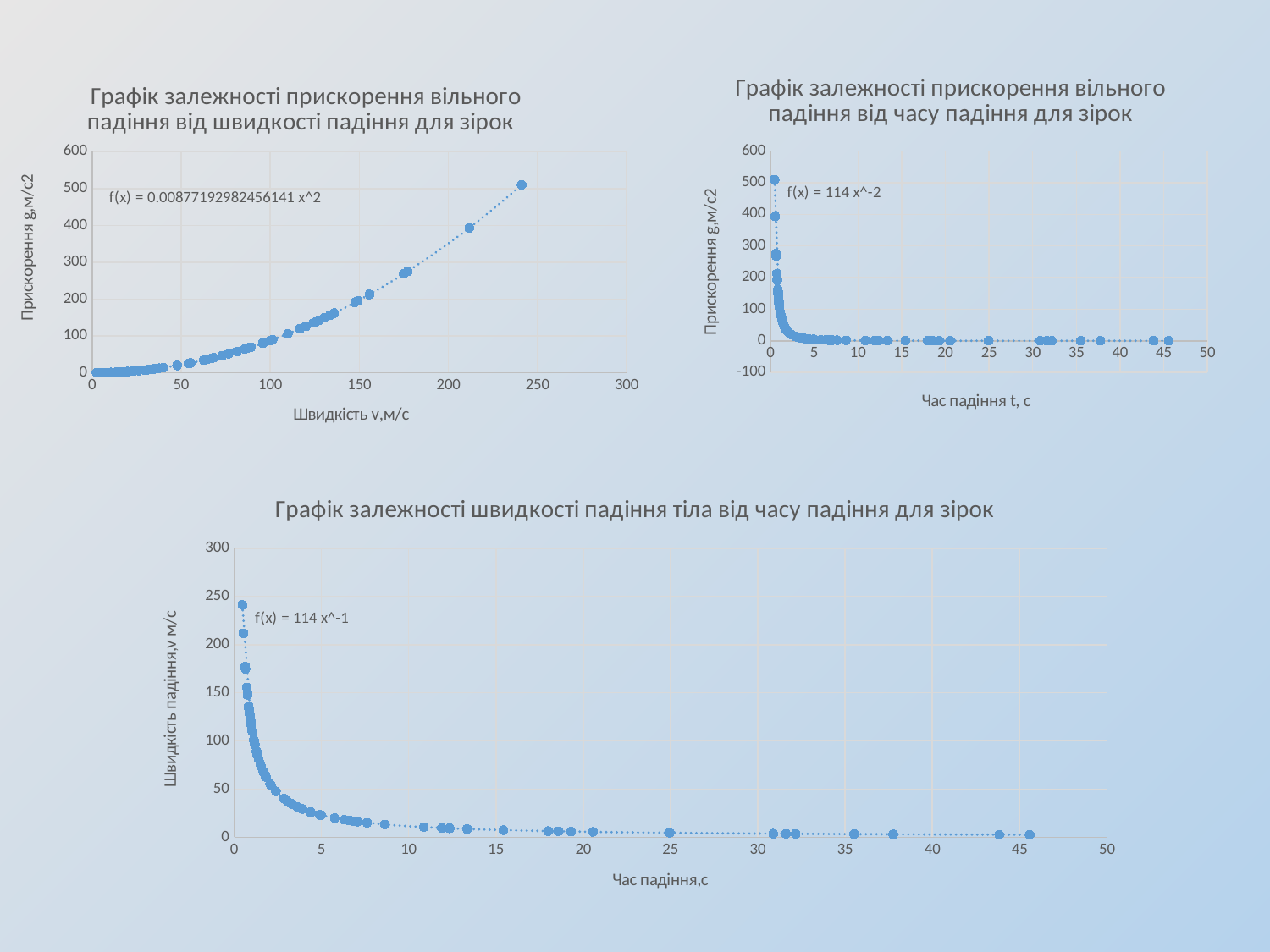
What is the trendline equation shown on the bottom chart (speed of fall vs. time)? f(x) = 114 x^-1 In the top-right chart, is the acceleration value at a time of about 5 с greater or less than 100? less In the bottom chart, is the speed value at the first point (time about 0.5 с) greater or less than 200? greater In the bottom chart, is the speed value at a time of about 10 с greater or less than 50? less In the top-left chart (acceleration vs. speed), do the plotted values rise or fall as the speed increases along the x axis? rise What kind of chart is the top-left chart titled 'Графік залежності прискорення вільного падіння від швидкості падіння для зірок'? scatter chart How many charts are shown on the slide? 3 What kind of chart is the bottom chart titled 'Графік залежності швидкості падіння тіла від часу падіння для зірок'? scatter chart In the top-right chart (acceleration vs. time of fall), do the plotted values rise or fall as time increases along the x axis? fall In the bottom chart (speed of fall vs. time), do the plotted values rise or fall as time increases along the x axis? fall